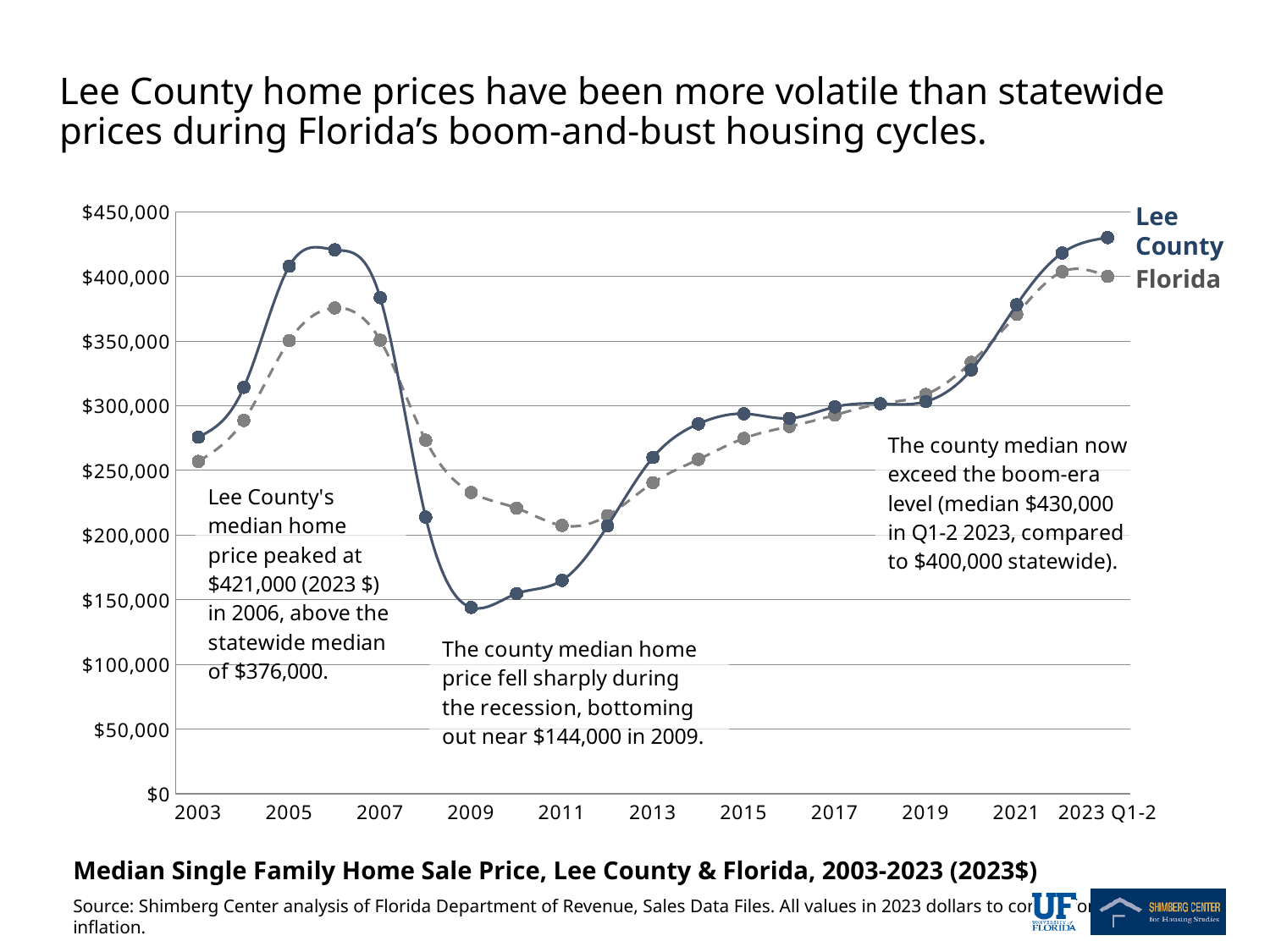
What is the difference between the Lee County and Florida medians in Q1-2 2023? $30,000 What kind of chart is shown on the slide? line chart What is the Florida statewide median home price in Q1-2 2023? $400,000 What was the statewide (Florida) median home price in 2006, according to the chart annotation? $376,000 Is the Lee County value for 2009 greater or less than $150,000? less Did the Lee County median home price rise or fall between 2006 and 2009? fall How many series does the chart's legend list? 2 What was Lee County's median home price at its 2006 peak, according to the chart annotation? $421,000 In 2006, which series had the higher median home price, Lee County or Florida? Lee County What is the Lee County median home price in Q1-2 2023? $430,000 Is the Florida value for 2011 greater or less than $250,000? less By how much did Lee County's 2006 median home price exceed the statewide median that year? $45,000